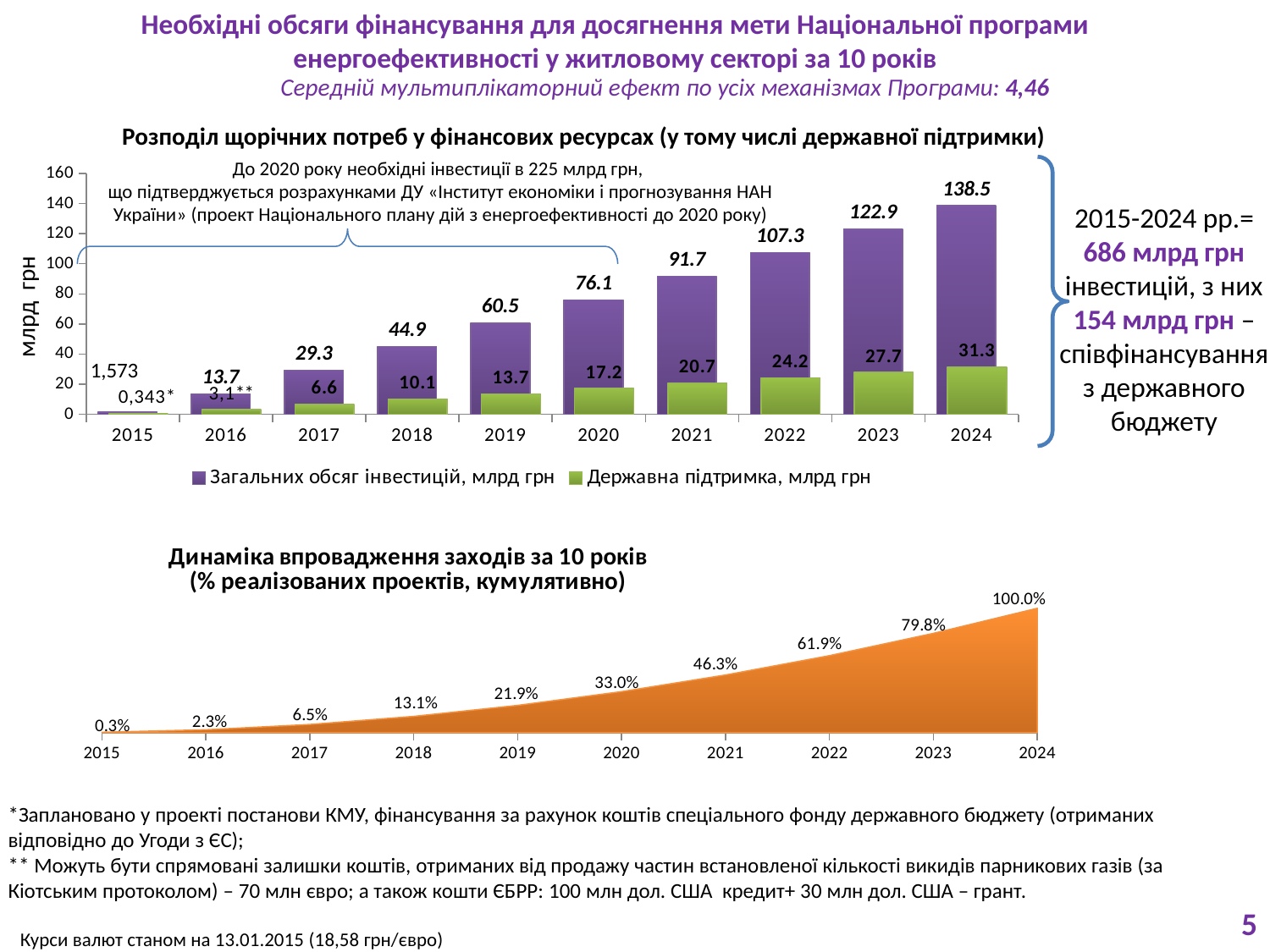
In the top chart, what is the value of Державна підтримка for 2020? 17.2 In the top chart, how many series does the legend list? 2 In the bottom chart, what is the difference between the values for 2024 and 2023? 20.2% In the bottom chart (Динаміка впровадження заходів за 10 років), what is the value for 2022? 61.9% In the top chart, which year has the highest value of Загальних обсяг інвестицій? 2024 In the top chart, what is the difference between Загальних обсяг інвестицій and Державна підтримка in 2023? 95.2 In the top chart (Розподіл щорічних потреб у фінансових ресурсах), what is the value of Загальних обсяг інвестицій for 2024? 138.5 In the top chart, which year has the lowest value of Державна підтримка? 2015 In the top chart, how many years are shown on the x axis? 10 In the top chart, which is larger: Загальних обсяг інвестицій in 2019 or in 2021? 2021 In the bottom chart, do the values rise or fall from 2015 to 2024? rise What kind of chart is the top chart? bar chart